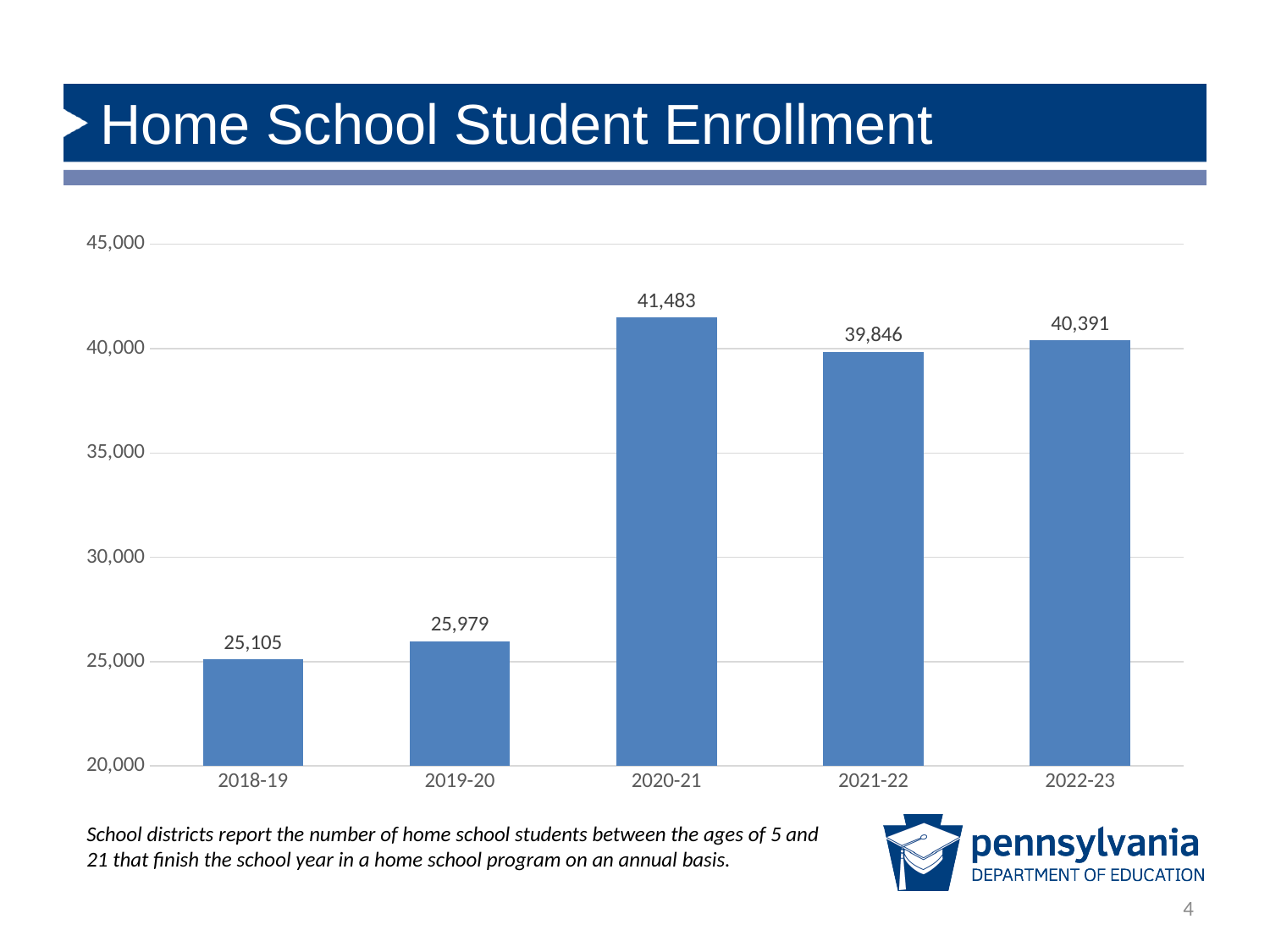
What is the home school student enrollment for 2020-21? 41,483 Which school year has the lowest home school student enrollment? 2018-19 What kind of chart is shown on the slide? bar chart How many school years are shown on the chart? 5 Which year has higher enrollment, 2021-22 or 2022-23? 2022-23 What is the difference in enrollment between 2019-20 and 2018-19? 874 What is the home school student enrollment for 2018-19? 25,105 What is the title of the slide? Home School Student Enrollment What is the difference in enrollment between 2020-21 and 2021-22? 1,637 Is the enrollment for 2019-20 greater or less than 30,000? less What is the home school student enrollment for 2022-23? 40,391 Which school year has the highest home school student enrollment? 2020-21